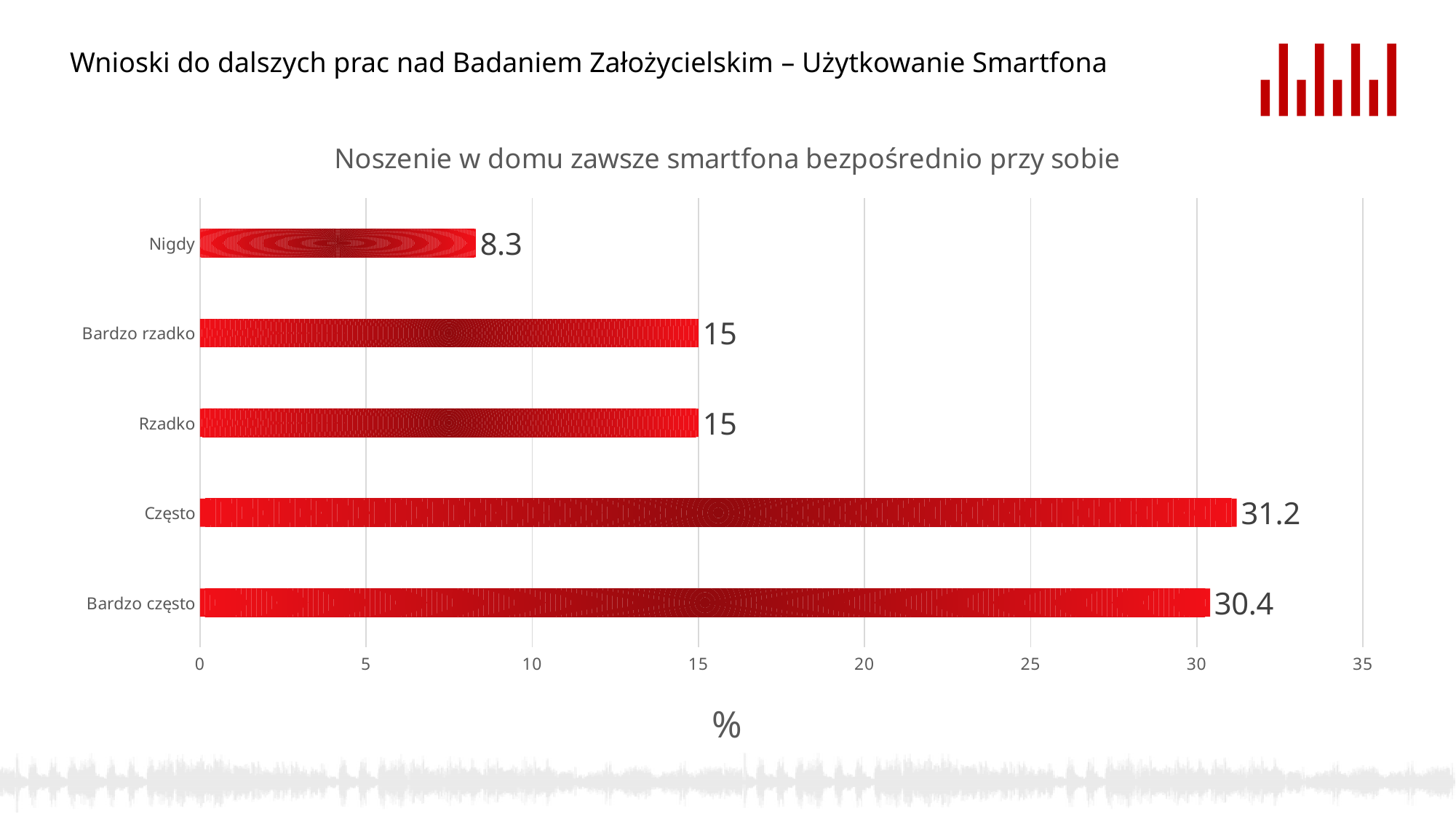
Which category has the highest value? Często Which category has the lowest value? Nigdy What is the value for Rzadko? 15 What kind of chart is shown on the slide? Bar chart Which is larger, the value for Bardzo rzadko or the value for Nigdy? Bardzo rzadko What is the title of the chart? Noszenie w domu zawsze smartfona bezpośrednio przy sobie What is the value for Nigdy? 8.3 What is the value for Często? 31.2 What is the difference between the values for Często and Bardzo często? 0.8 What is the difference between the values for Bardzo rzadko and Nigdy? 6.7 What is the value for Bardzo często? 30.4 How many categories are shown in the chart? 5